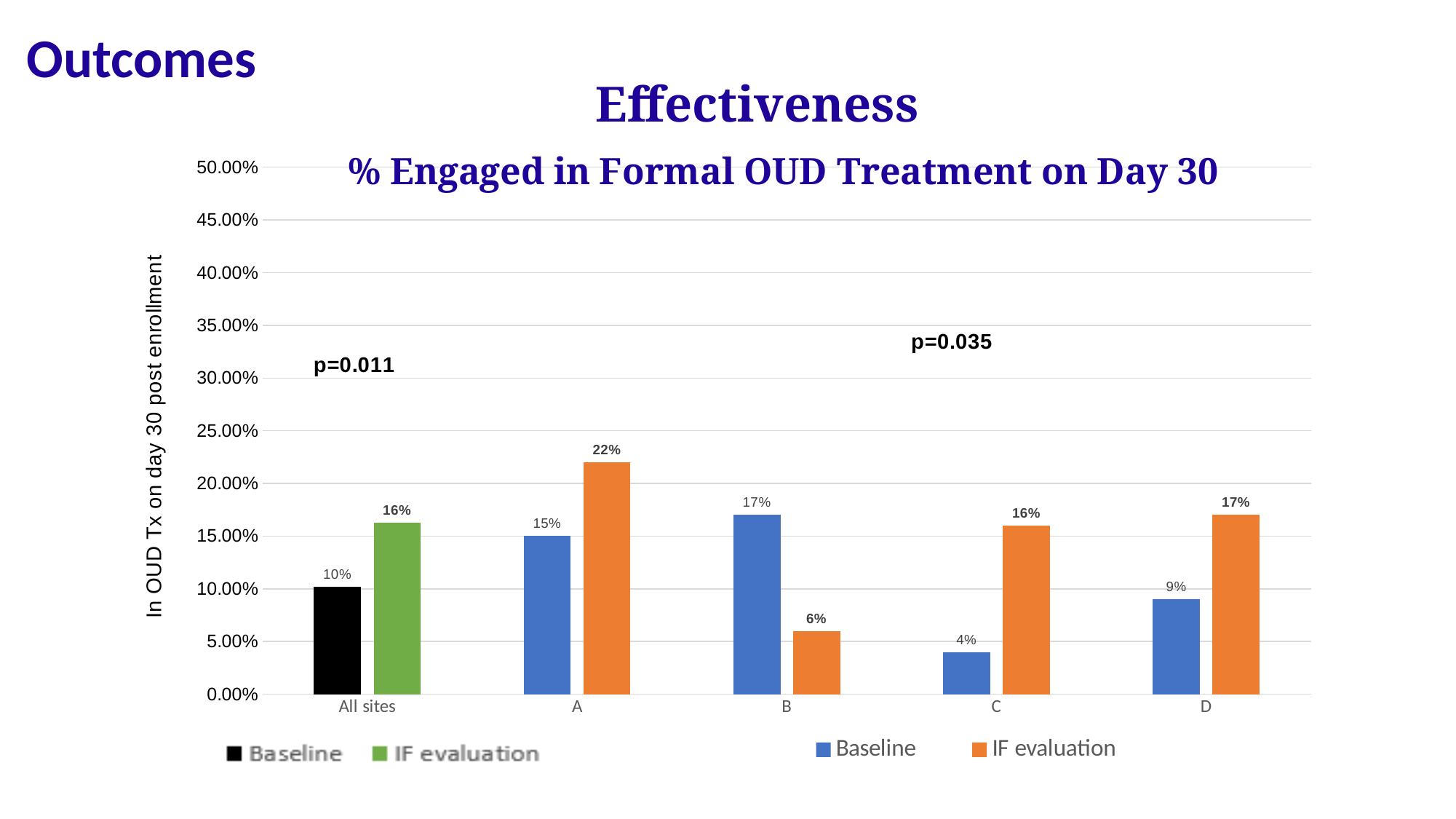
Which is larger for site B, the Baseline value or the IF evaluation value? Baseline What is the IF evaluation value for site A? 22% How many categories are shown on the x axis? 5 Which category has the lowest Baseline value? C Which category has the highest IF evaluation value? A What is the Baseline value for All sites? 10% What is the difference between the IF evaluation and Baseline values for site C? 12% How many series does the legend list? 2 What is the Baseline value for site C? 4% What is the IF evaluation value for site B? 6% What is the title of the chart? % Engaged in Formal OUD Treatment on Day 30 What kind of chart is shown on the slide? Bar chart